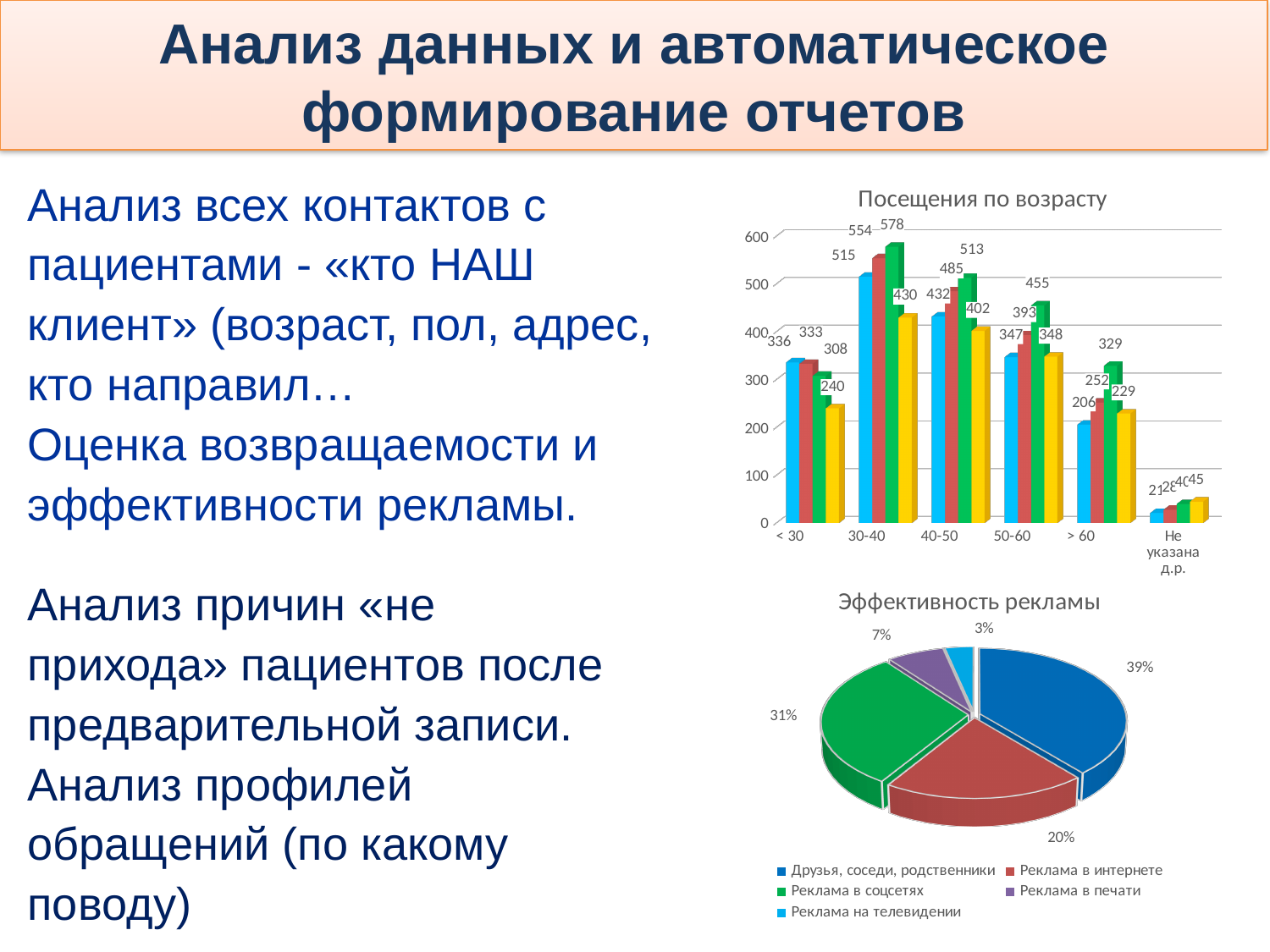
In the chart titled "Посещения по возрасту", what is the difference between the red bar for 30-40 (554) and the red bar for 40-50 (485)? 69 In the chart titled "Посещения по возрасту", what is the value of the green bar for the 30-40 age group? 578 In the chart titled "Посещения по возрасту", what is the value of the blue bar for the < 30 age group? 336 In the chart titled "Посещения по возрасту", what is the value of the yellow bar for the 40-50 age group? 402 In the chart titled "Посещения по возрасту", which age group has the highest green bar? 30-40 What kind of chart is "Посещения по возрасту"? bar chart How many entries does the legend of the pie chart "Эффективность рекламы" list? 5 In the chart titled "Посещения по возрасту", which is larger: the green bar for 50-60 or the green bar for > 60? 50-60 In the pie chart titled "Эффективность рекламы", which category has the largest slice? Друзья, соседи, родственники In the chart titled "Посещения по возрасту", which age group has the lowest blue bar? Не указана д.р. In the chart titled "Посещения по возрасту", how many age categories are shown on the x axis? 6 In the pie chart titled "Эффективность рекламы", what share does "Реклама в соцсетях" have? 31%